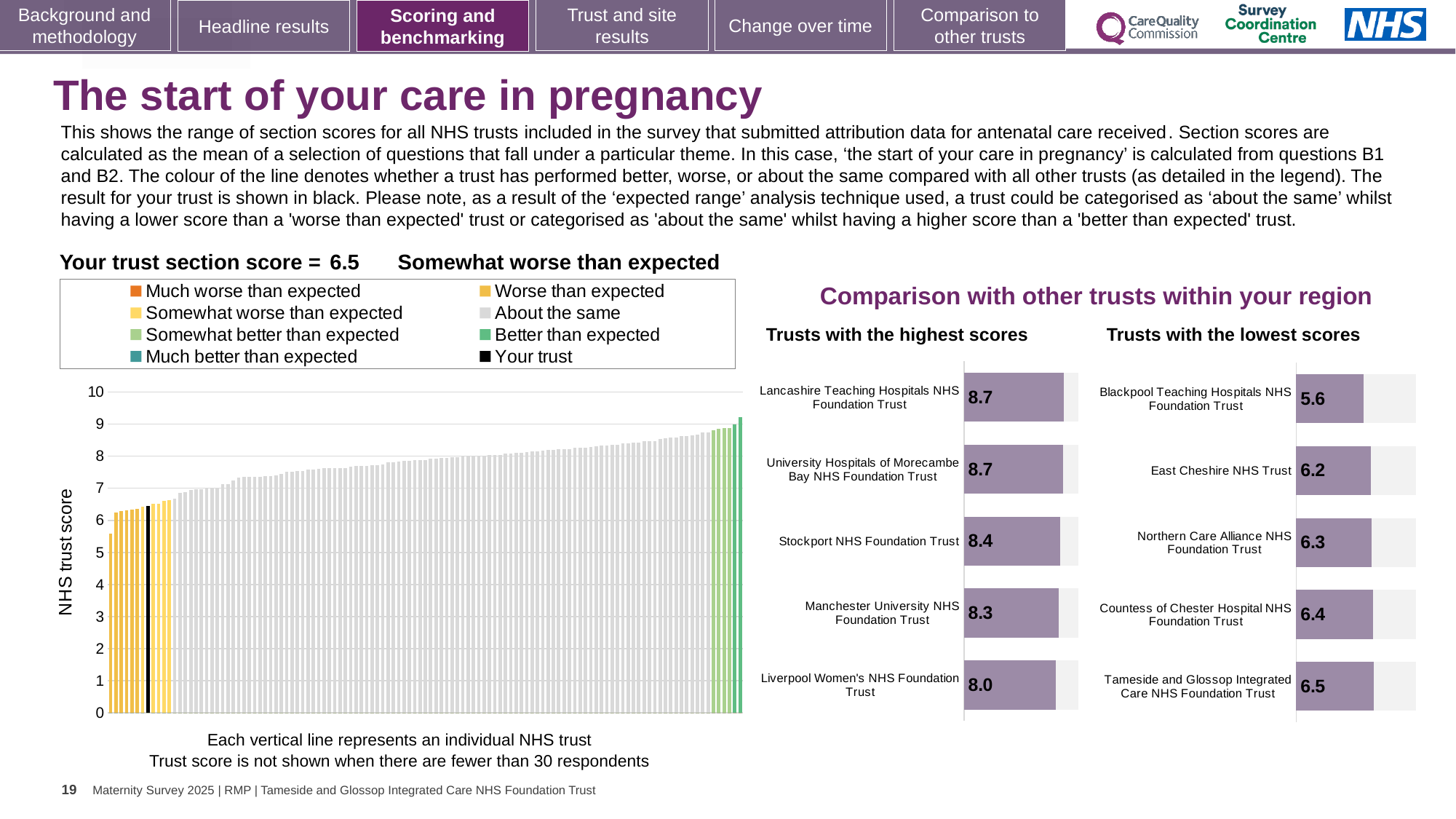
In the 'Trusts with the highest scores' chart, which has the larger score: Manchester University NHS Foundation Trust or Stockport NHS Foundation Trust? Stockport NHS Foundation Trust In the 'Trusts with the lowest scores' chart, which trust has the highest score? Tameside and Glossop Integrated Care NHS Foundation Trust In the 'Trusts with the highest scores' chart, what is the score for Stockport NHS Foundation Trust? 8.4 In the 'Trusts with the lowest scores' chart, what is the score for Blackpool Teaching Hospitals NHS Foundation Trust? 5.6 How many entries does the legend of the NHS trust score chart on the left list? 8 In the 'Trusts with the highest scores' chart, which trust has the lowest score? Liverpool Women's NHS Foundation Trust In the 'Trusts with the lowest scores' chart, which trust has the lowest score? Blackpool Teaching Hospitals NHS Foundation Trust In the 'Trusts with the highest scores' chart, what is the difference between the scores of Stockport NHS Foundation Trust and Liverpool Women's NHS Foundation Trust? 0.4 In the NHS trust score chart on the left, do the bar values rise or fall from left to right? Rise How many trusts are shown in the 'Trusts with the highest scores' chart? 5 What kind of chart is the NHS trust score chart on the left of the slide? Bar chart In the 'Trusts with the lowest scores' chart, how much higher is the score for Tameside and Glossop Integrated Care NHS Foundation Trust than for Blackpool Teaching Hospitals NHS Foundation Trust? 0.9